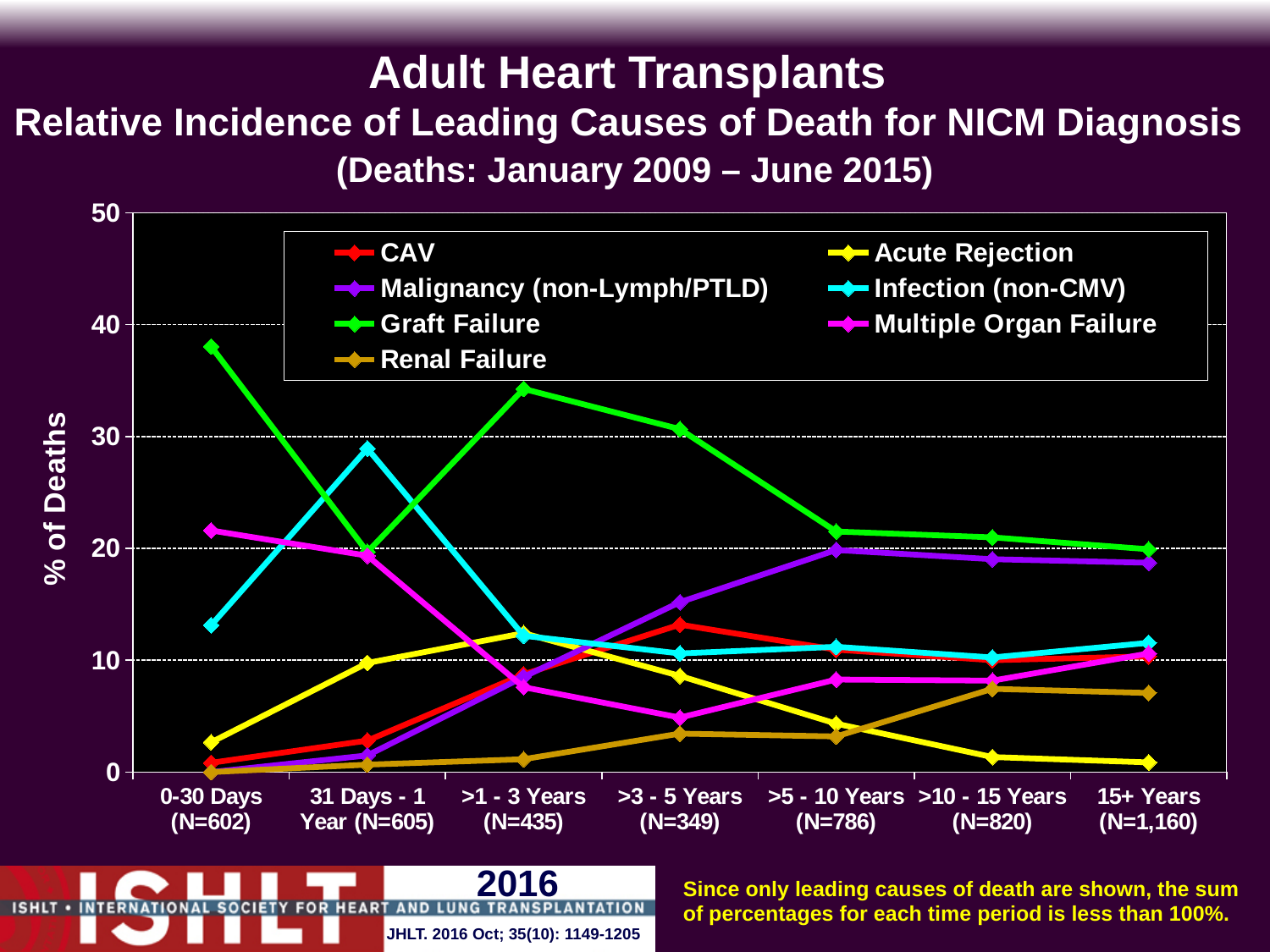
At >5 - 10 Years, which is larger: Malignancy (non-Lymph/PTLD) or Acute Rejection? Malignancy (non-Lymph/PTLD) How many time-period categories are shown on the x axis? 7 At 0-30 Days, which is larger: Graft Failure or Infection (non-CMV)? Graft Failure What is the N shown for the 15+ Years category? N=1,160 Is the value for Acute Rejection at 15+ Years greater or less than 10? less Does the Acute Rejection line rise or fall from >1 - 3 Years to 15+ Years? Fall Is the value for Multiple Organ Failure at 0-30 Days greater or less than 20? greater Which cause of death has the highest % of Deaths at >3 - 5 Years? Graft Failure Is the value for Graft Failure at 0-30 Days greater or less than 30? greater What kind of chart is shown on the slide? Line chart How many series does the legend list? 7 Which cause of death has the highest % of Deaths at 0-30 Days? Graft Failure